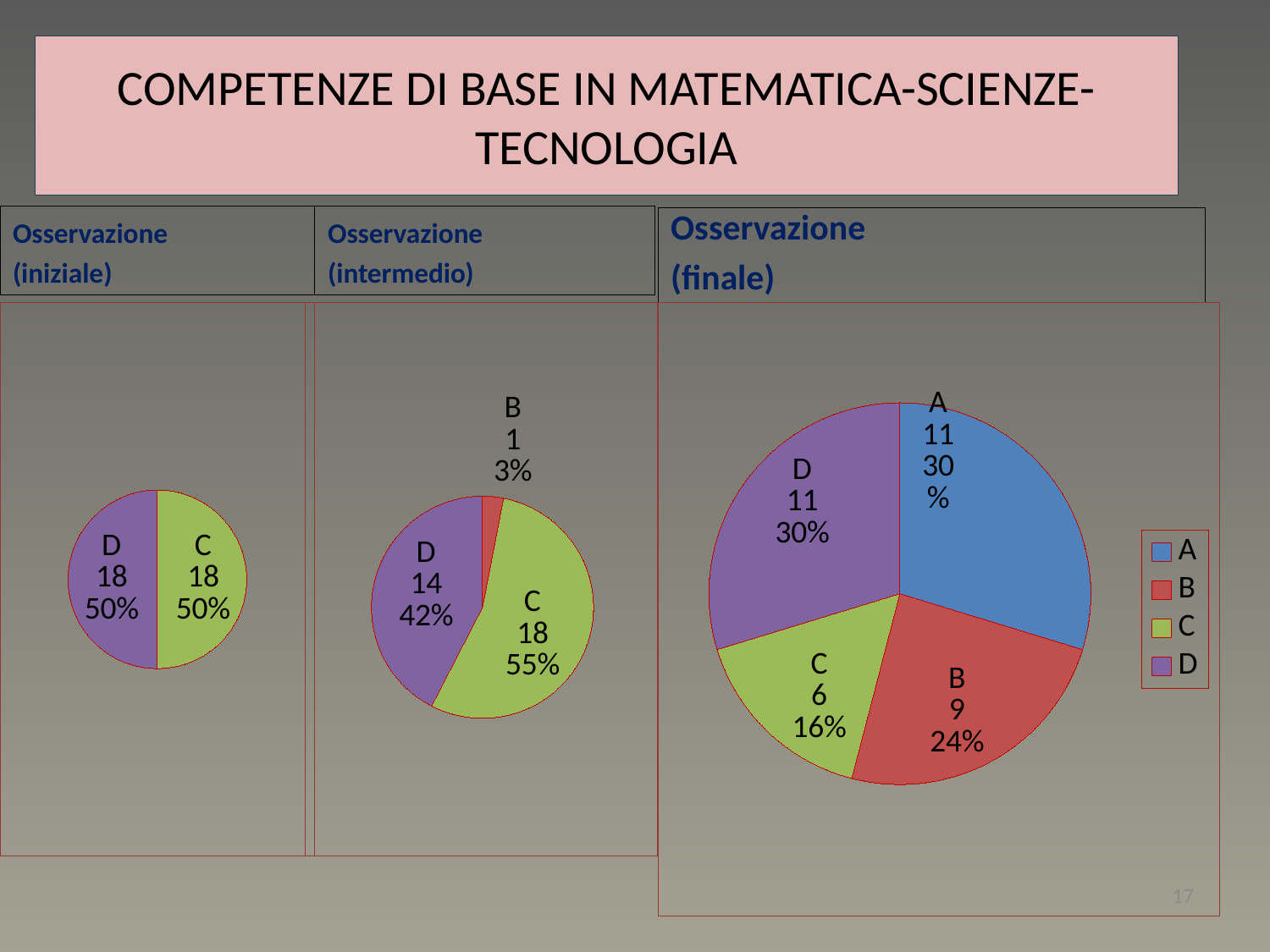
What type of chart is used for Osservazione (iniziale)? Pie chart In the Osservazione (finale) pie chart, what percentage share does category C have? 16% In the Osservazione (finale) pie chart, what is the difference between the values for A and C? 5 In the Osservazione (finale) pie chart, which category has the smallest value? C In the Osservazione (intermedio) pie chart, which is larger, the value for C or the value for D? C How many entries does the legend next to the Osservazione (finale) chart list? 4 In the Osservazione (intermedio) pie chart, what is the value for category D? 14 How many categories are shown in the Osservazione (finale) pie chart? 4 How many categories are shown in the Osservazione (iniziale) pie chart? 2 In the Osservazione (finale) pie chart, what is the value for category B? 9 In the Osservazione (intermedio) pie chart, which category has the smallest value? B In the Osservazione (intermedio) pie chart, what percentage share does category C have? 55%